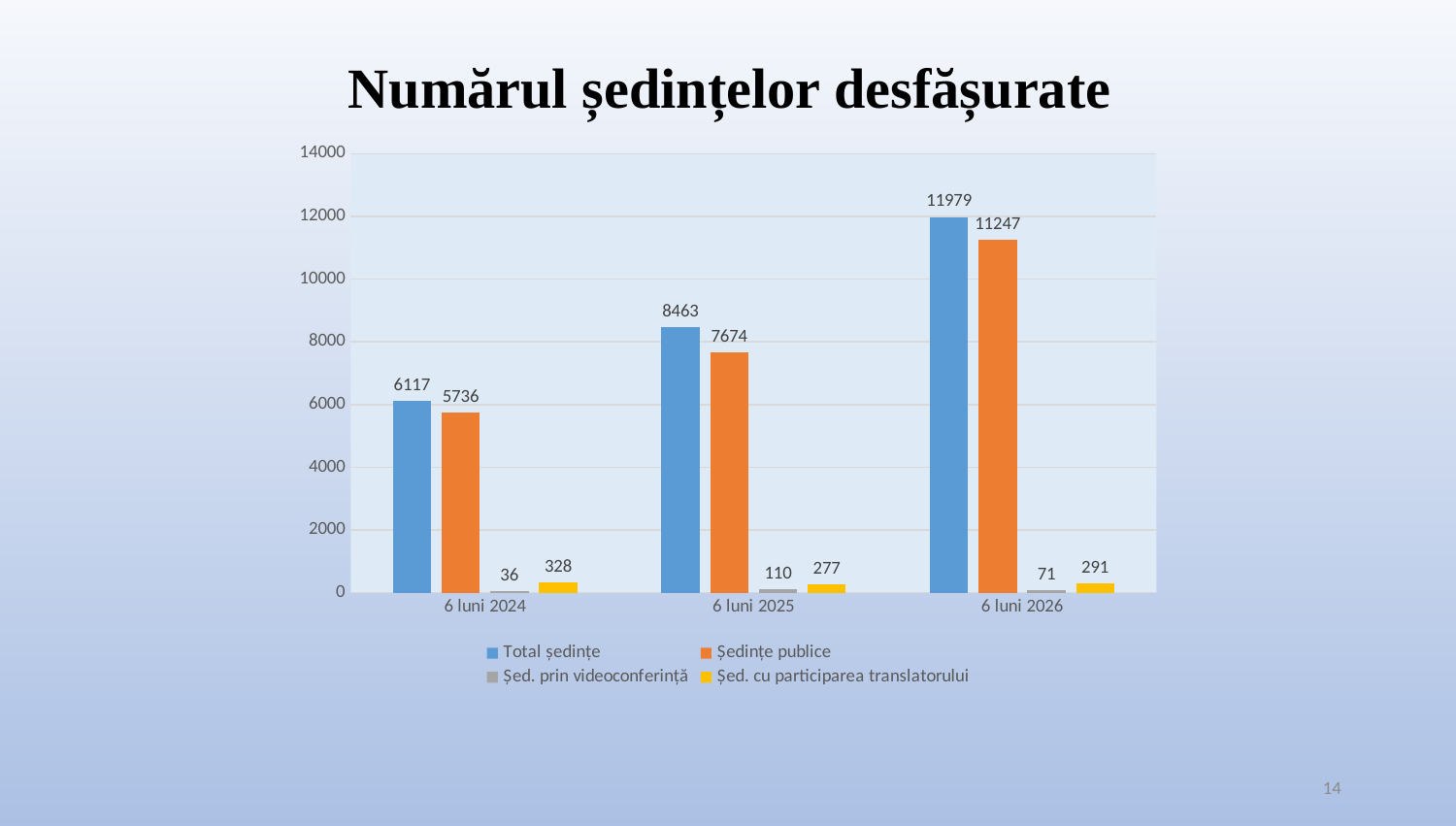
How many periods are shown on the x axis? 3 Which period has the highest value for Total ședințe? 6 luni 2026 What is the value of Total ședințe for 6 luni 2025? 8463 Does the value of Ședințe publice rise or fall from 6 luni 2024 to 6 luni 2026? Rise Which period has the lowest value for Șed. cu participarea translatorului? 6 luni 2025 Which is larger: Șed. prin videoconferință for 6 luni 2025 or for 6 luni 2026? 6 luni 2025 What is the value of Ședințe publice for 6 luni 2026? 11247 What is the value of Șed. cu participarea translatorului for 6 luni 2025? 277 What is the value of Șed. prin videoconferință for 6 luni 2024? 36 How many series does the legend list? 4 What is the difference between Total ședințe and Ședințe publice for 6 luni 2024? 381 What kind of chart is shown on the slide? Bar chart